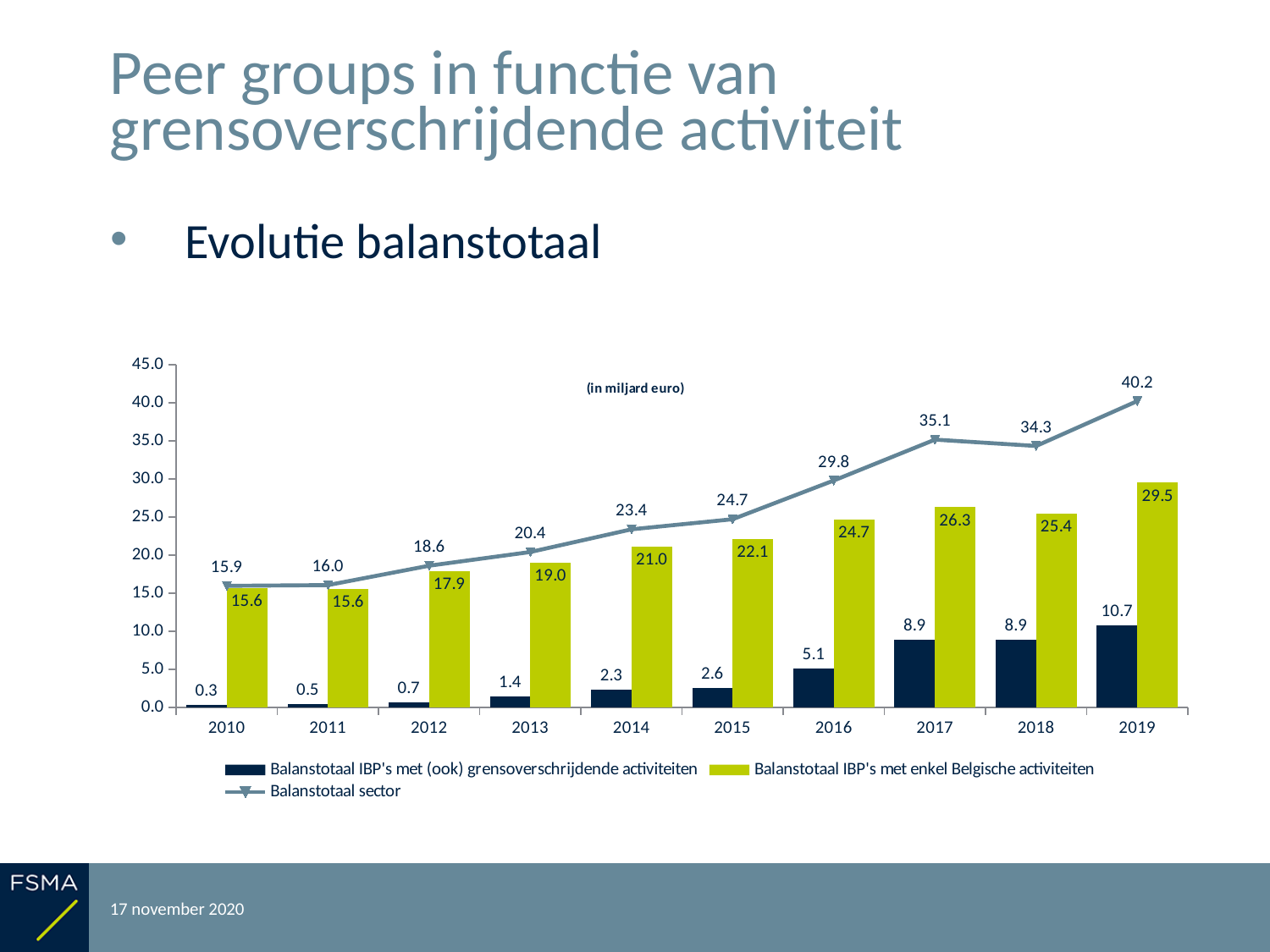
In which year is 'Balanstotaal sector' lowest? 2010 What unit is stated on the chart? in miljard euro Does 'Balanstotaal IBP's met (ook) grensoverschrijdende activiteiten' generally rise or fall from 2010 to 2019? rise What is the value of 'Balanstotaal IBP's met enkel Belgische activiteiten' in 2016? 24.7 In which year is 'Balanstotaal IBP's met (ook) grensoverschrijdende activiteiten' highest? 2019 How many years are shown on the x axis? 10 What is the difference between 'Balanstotaal sector' in 2019 and in 2010? 24.3 What is the value of 'Balanstotaal sector' in 2019? 40.2 How many series does the legend list? 3 Which is larger: 'Balanstotaal IBP's met enkel Belgische activiteiten' in 2017 or in 2018? 2017 Is the value of 'Balanstotaal sector' in 2016 greater or less than 25.0? greater What is the value of 'Balanstotaal IBP's met (ook) grensoverschrijdende activiteiten' in 2013? 1.4